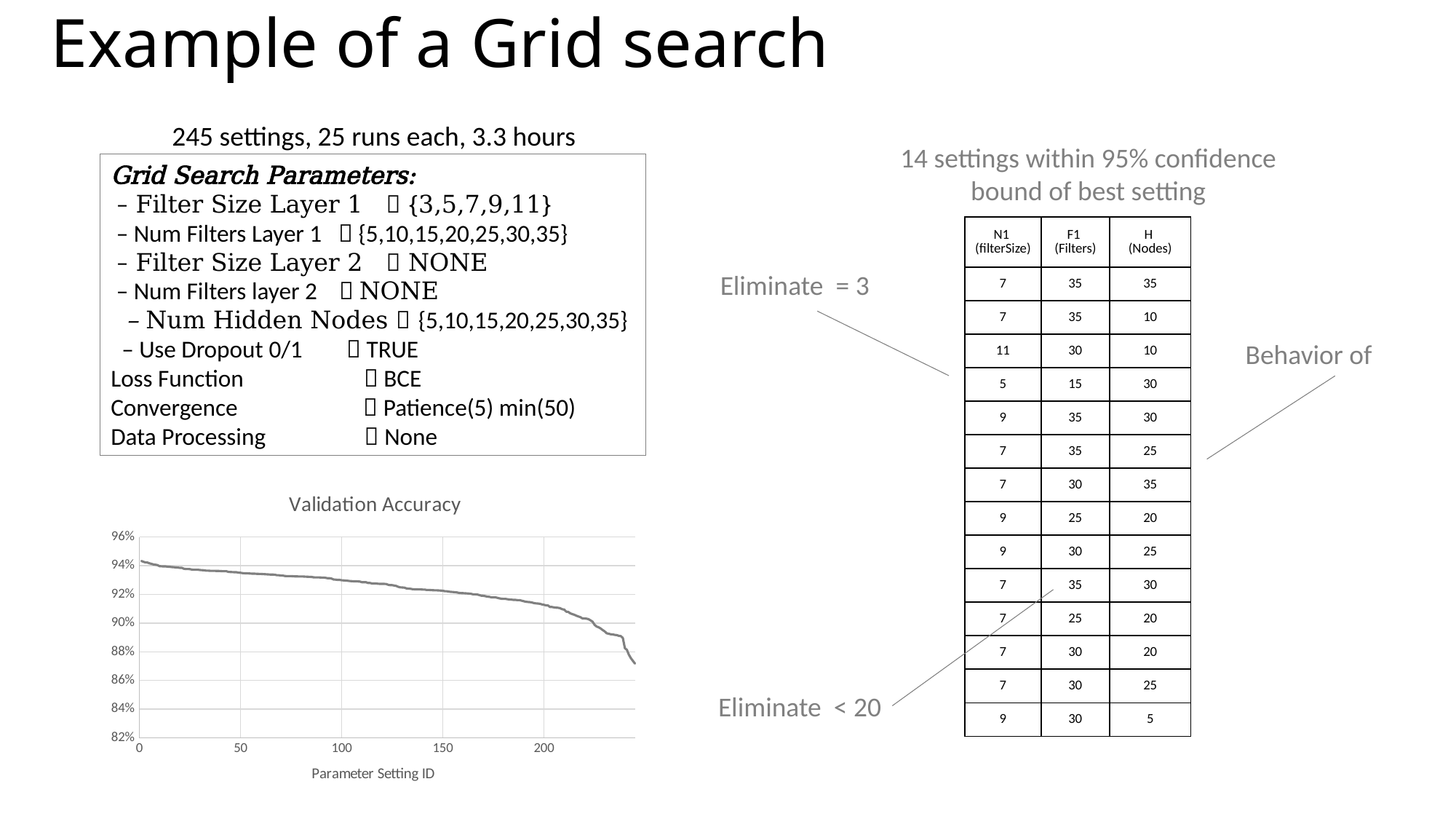
In the Validation Accuracy chart, is the value at Parameter Setting ID 50 greater or less than 94%? less In the Validation Accuracy chart, is the value at Parameter Setting ID 100 greater or less than 90%? greater What is the x-axis title of the Validation Accuracy chart? Parameter Setting ID What kind of chart is the Validation Accuracy chart? line chart In the Validation Accuracy chart, do the values rise or fall as the Parameter Setting ID increases? fall In the Validation Accuracy chart, is the value at Parameter Setting ID 150 greater or less than 90%? greater In the Validation Accuracy chart, which has the higher validation accuracy: Parameter Setting ID 0 or Parameter Setting ID 200? Parameter Setting ID 0 What is the title of the chart on the slide? Validation Accuracy